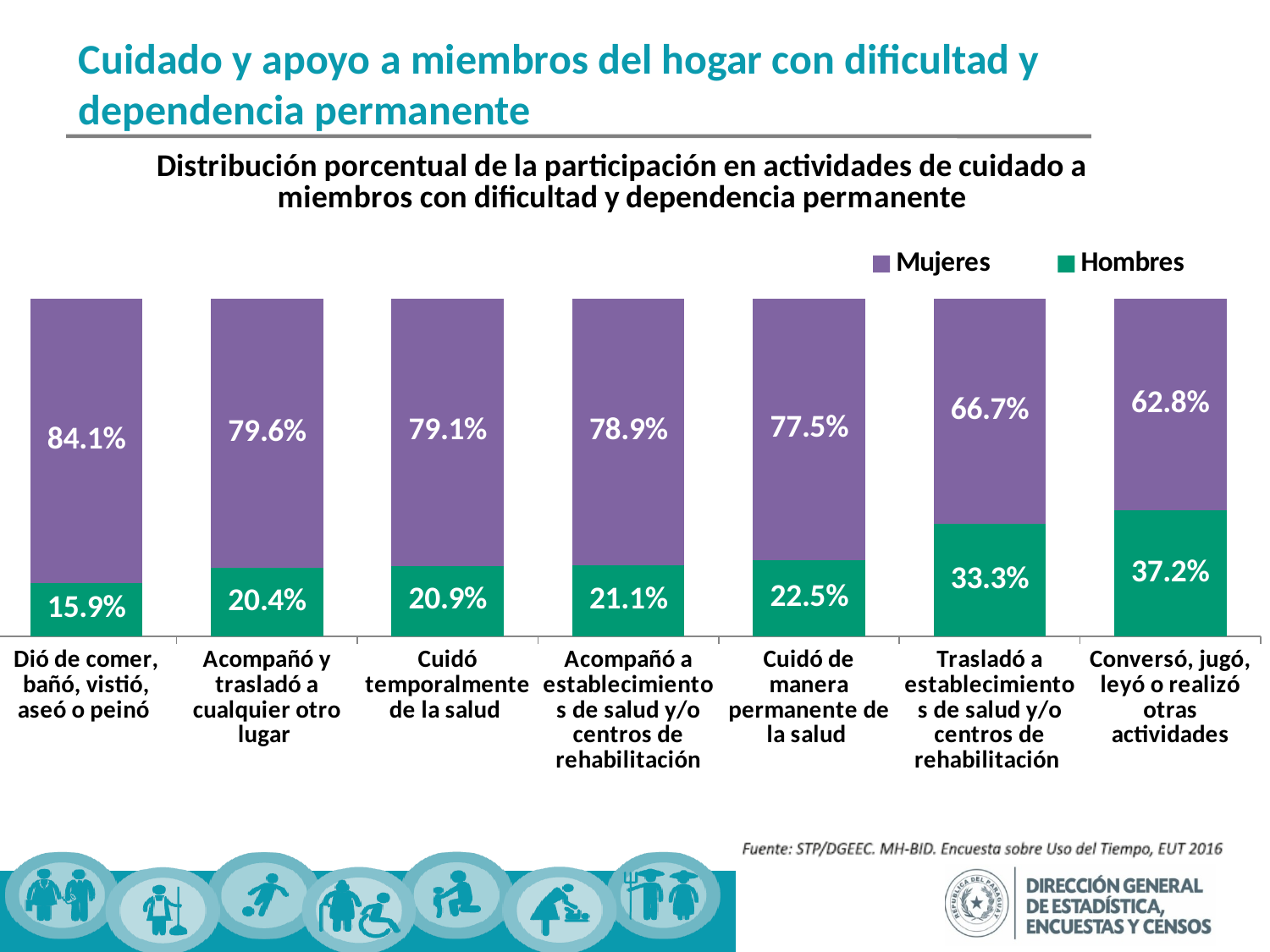
Do the Hombres values rise or fall from left to right along the x axis? Rise What kind of chart is shown on the slide? Stacked bar chart How many series does the legend list? 2 What is the Hombres value for "Cuidó de manera permanente de la salud"? 22.5% Which is larger: the Hombres value for "Acompañó y trasladó a cualquier otro lugar" or the Hombres value for "Cuidó temporalmente de la salud"? Cuidó temporalmente de la salud Which colour represents Mujeres in the chart? Purple What is the Mujeres value for "Dió de comer, bañó, vistió, aseó o peinó"? 84.1% Which category has the highest Mujeres value? Dió de comer, bañó, vistió, aseó o peinó How many categories are shown on the x axis? 7 Which category has the lowest Hombres value? Dió de comer, bañó, vistió, aseó o peinó What is the Hombres value for "Conversó, jugó, leyó o realizó otras actividades"? 37.2% What is the difference between the Mujeres and Hombres values for "Trasladó a establecimientos de salud y/o centros de rehabilitación"? 33.4%